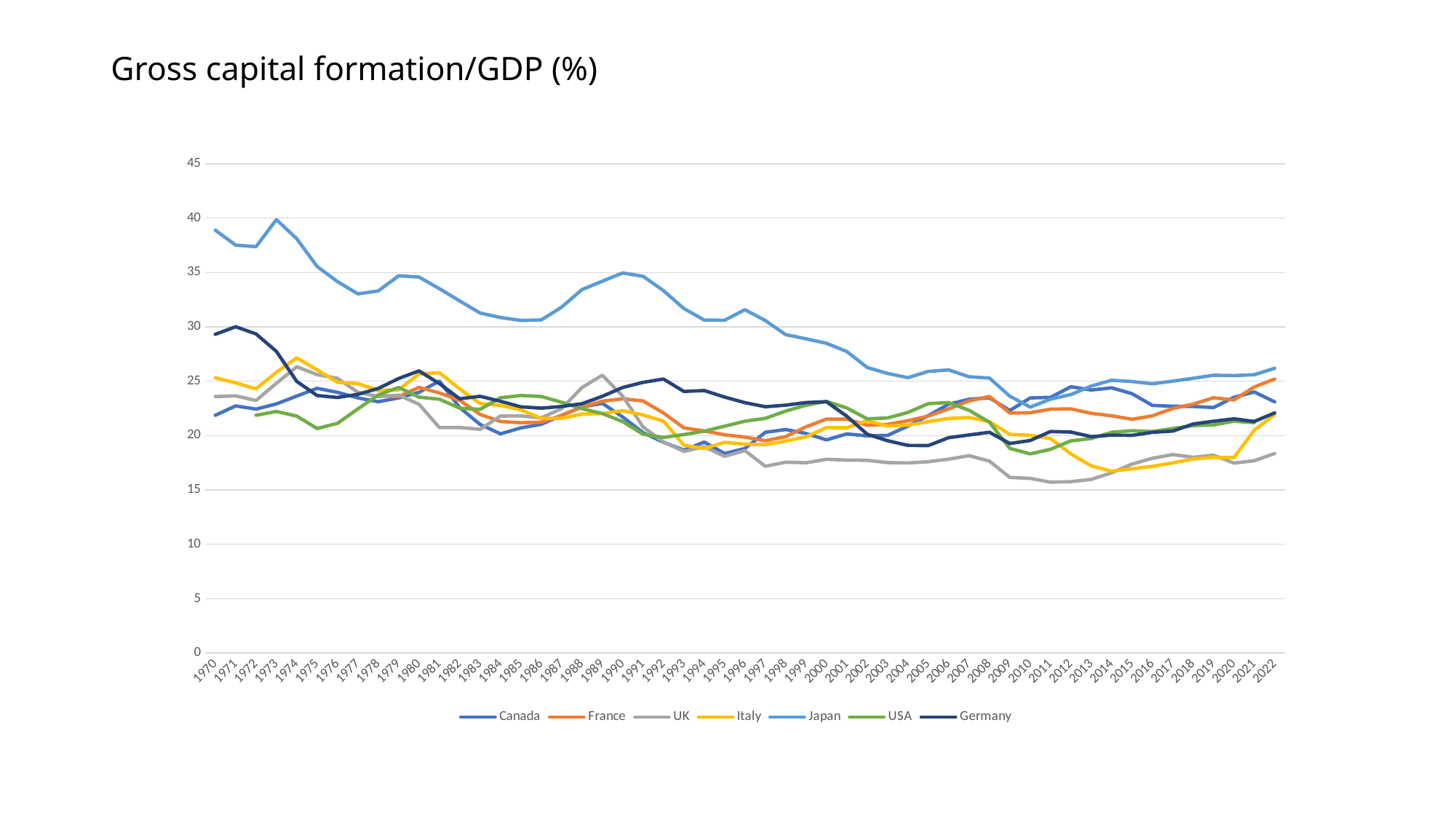
Which country has the lowest value in 2011? UK Is the value for Japan in 2022 greater or less than 20? greater Is the value for the UK in 2011 greater or less than 20? less What is the title of the chart? Gross capital formation/GDP (%) Is the value for Japan in 1970 greater or less than 35? greater How many years are plotted along the x axis? 53 Which country has the highest value in 1970? Japan What kind of chart is shown on the slide? line chart Which series is drawn in grey? UK How many series does the legend list? 7 Which is larger in 1973, the value for Japan or the value for Germany? Japan Does the value for Japan rise or fall overall from 1970 to 2022? fall